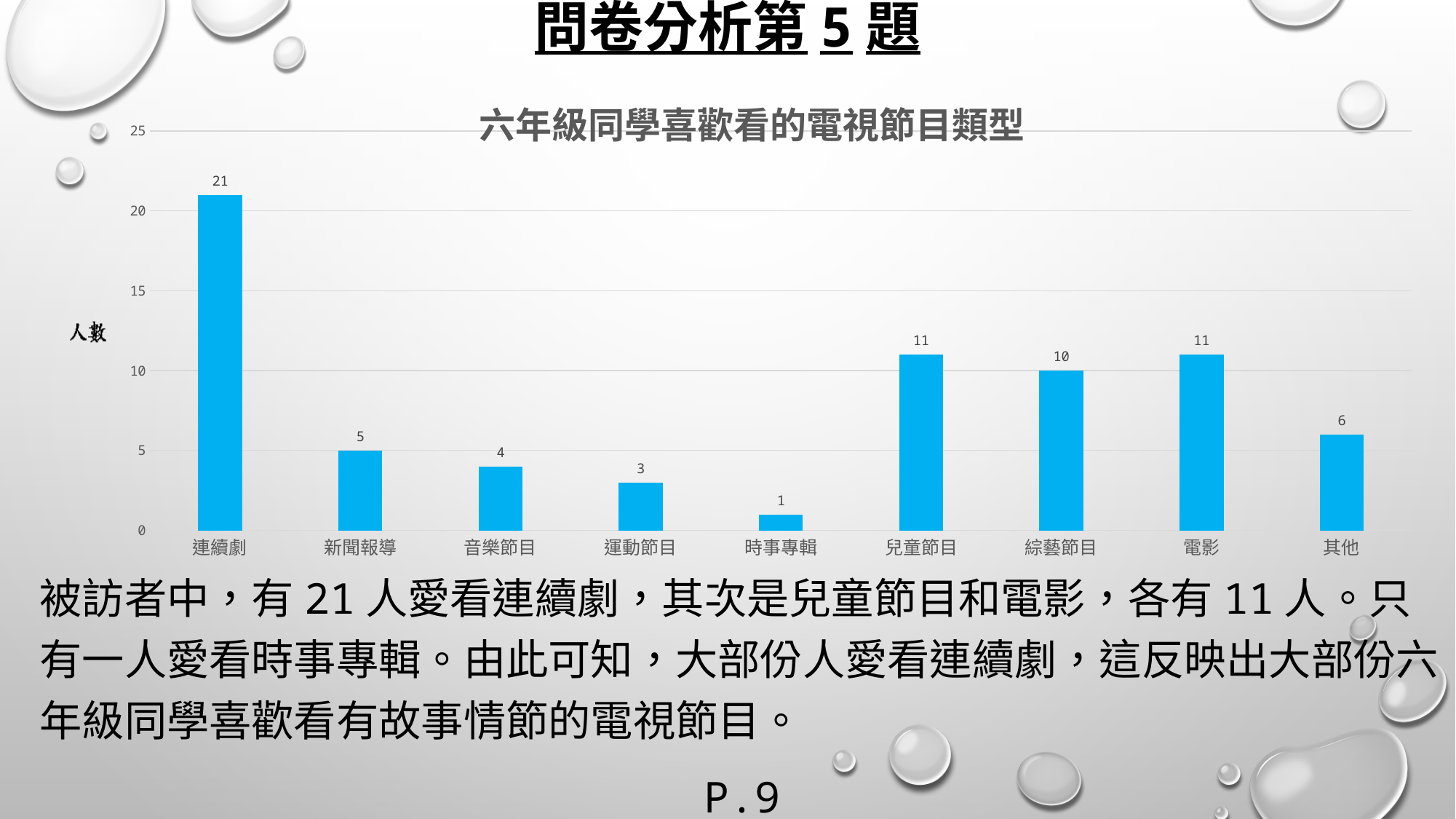
Which category has the lowest value? 時事專輯 What is the title of the chart? 六年級同學喜歡看的電視節目類型 What is the difference between the values for 新聞報導 and 運動節目? 2 What is the value for 連續劇? 21 What is the value for 綜藝節目? 10 How many categories are shown on the x axis? 9 Which category has the highest value? 連續劇 What is the value for 其他? 6 What kind of chart is shown on the slide? bar chart What is the difference between the values for 連續劇 and 電影? 10 Which is larger, the value for 兒童節目 or the value for 其他? 兒童節目 Is the value for 連續劇 greater or less than 20? greater